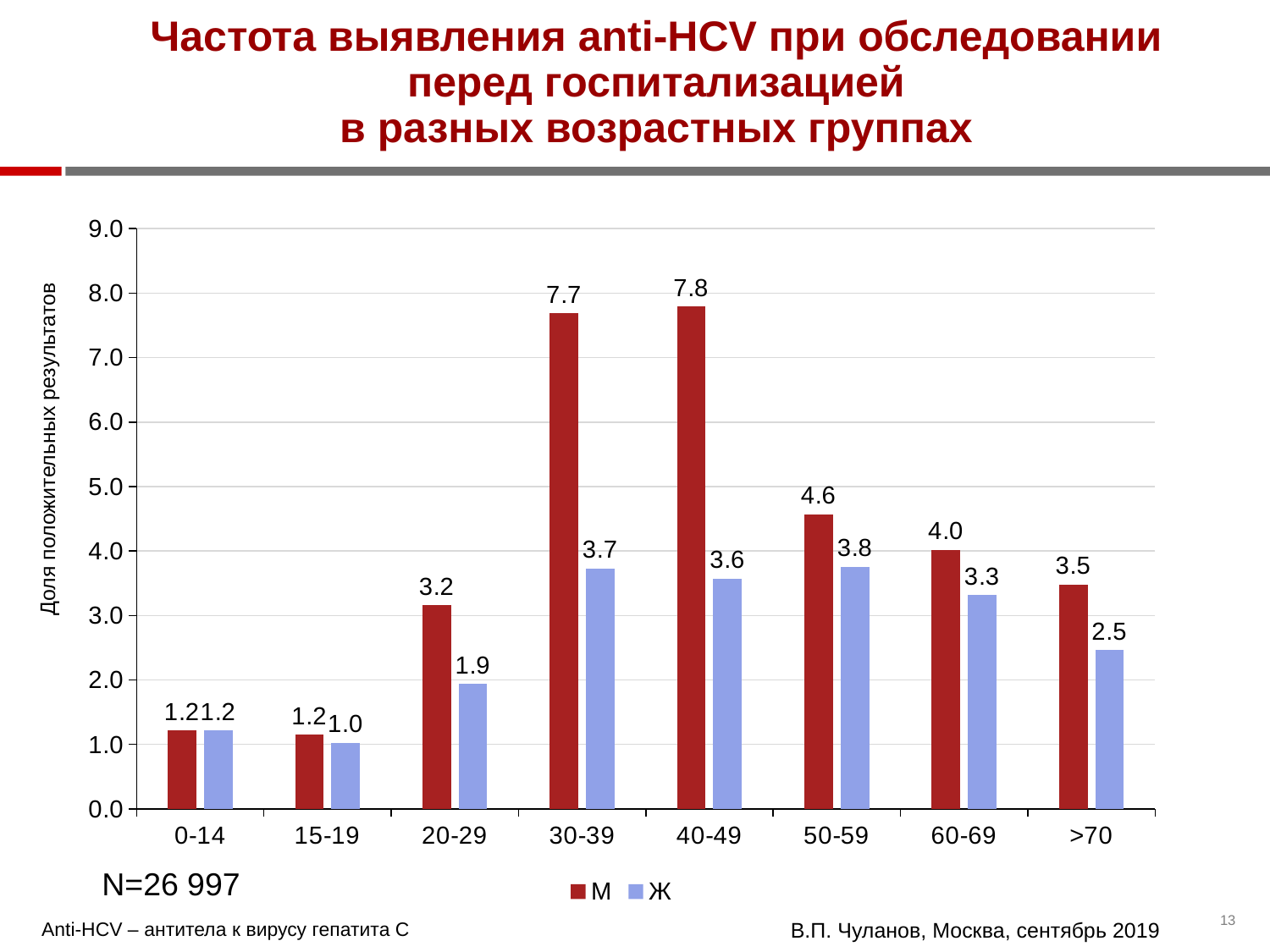
What is the value for Ж in the 20-29 age group? 1.9 What is the difference between the М and Ж values in the 40-49 age group? 4.2 How many series does the legend list? 2 Which is larger in the 50-59 age group, the value for М or for Ж? М How many age groups are shown on the x axis? 8 What is the value for М in the 30-39 age group? 7.7 Do the values for Ж rise or fall from the 50-59 age group to the >70 age group? fall What sample size (N) is stated below the chart? N=26 997 What type of chart is shown on the slide? bar chart Which age group has the highest value for М? 40-49 Is the value for Ж in the 60-69 age group greater or less than 3.0? greater Which age group has the lowest value for Ж? 15-19